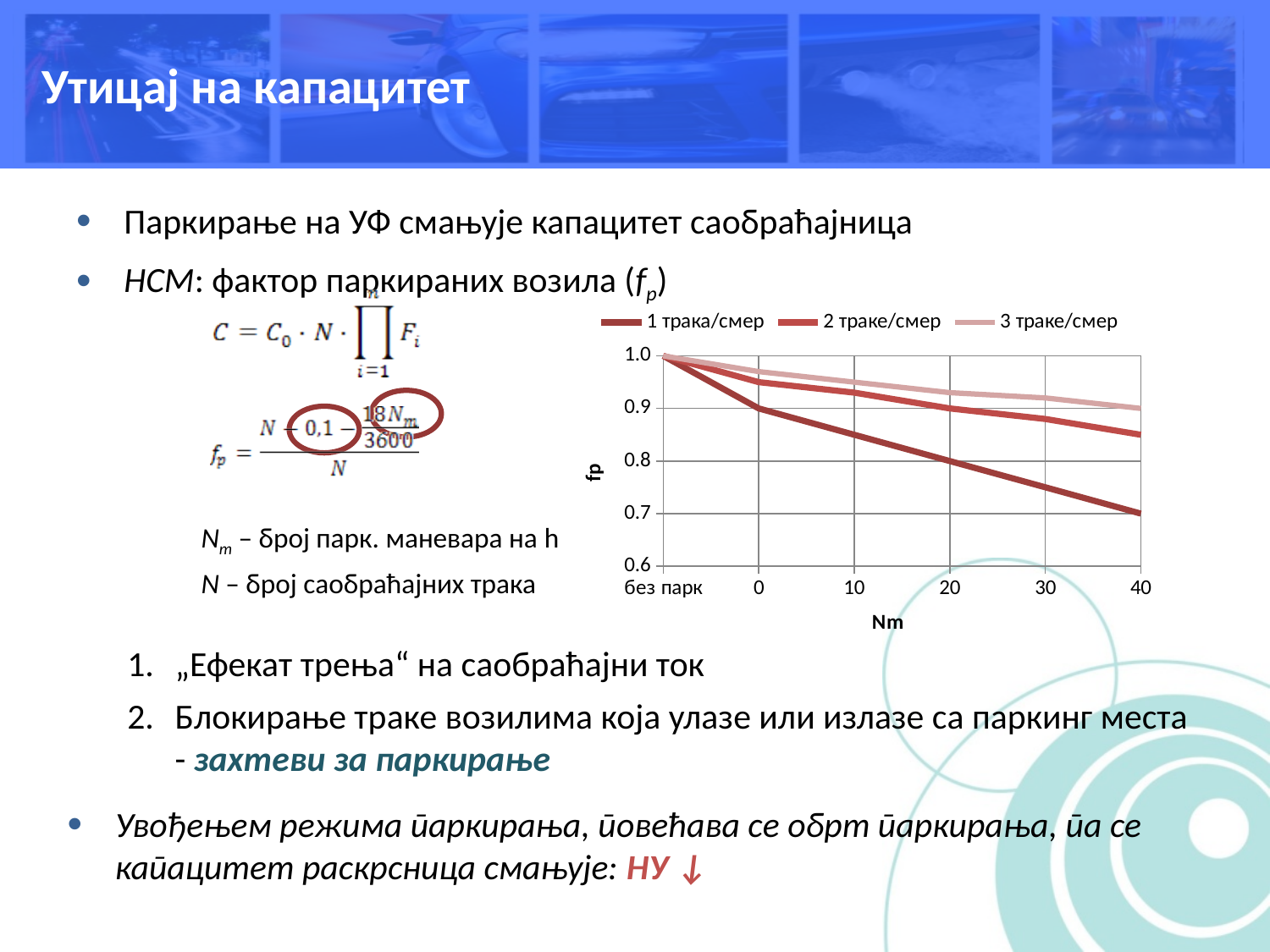
What is the value of fp for 1 трака/смер at Nm = 20? 0.8 How many points are marked along the Nm axis of the chart? 6 Do the fp values rise or fall as Nm increases along the x axis? fall What kind of chart is shown on the slide? line chart What is the value of fp for 2 траке/смер at Nm = 20? 0.9 What is the label of the y axis of the chart? fp Is the value of fp for 2 траке/смер at Nm = 40 greater or less than 0.8? greater How many series does the chart legend list? 3 What is the value of fp for 3 траке/смер at Nm = 40? 0.9 What is the value of fp for 1 трака/смер at Nm = 40? 0.7 Which series has the lowest fp at Nm = 40? 1 трака/смер At Nm = 20, which series has the larger fp: 1 трака/смер or 3 траке/смер? 3 траке/смер